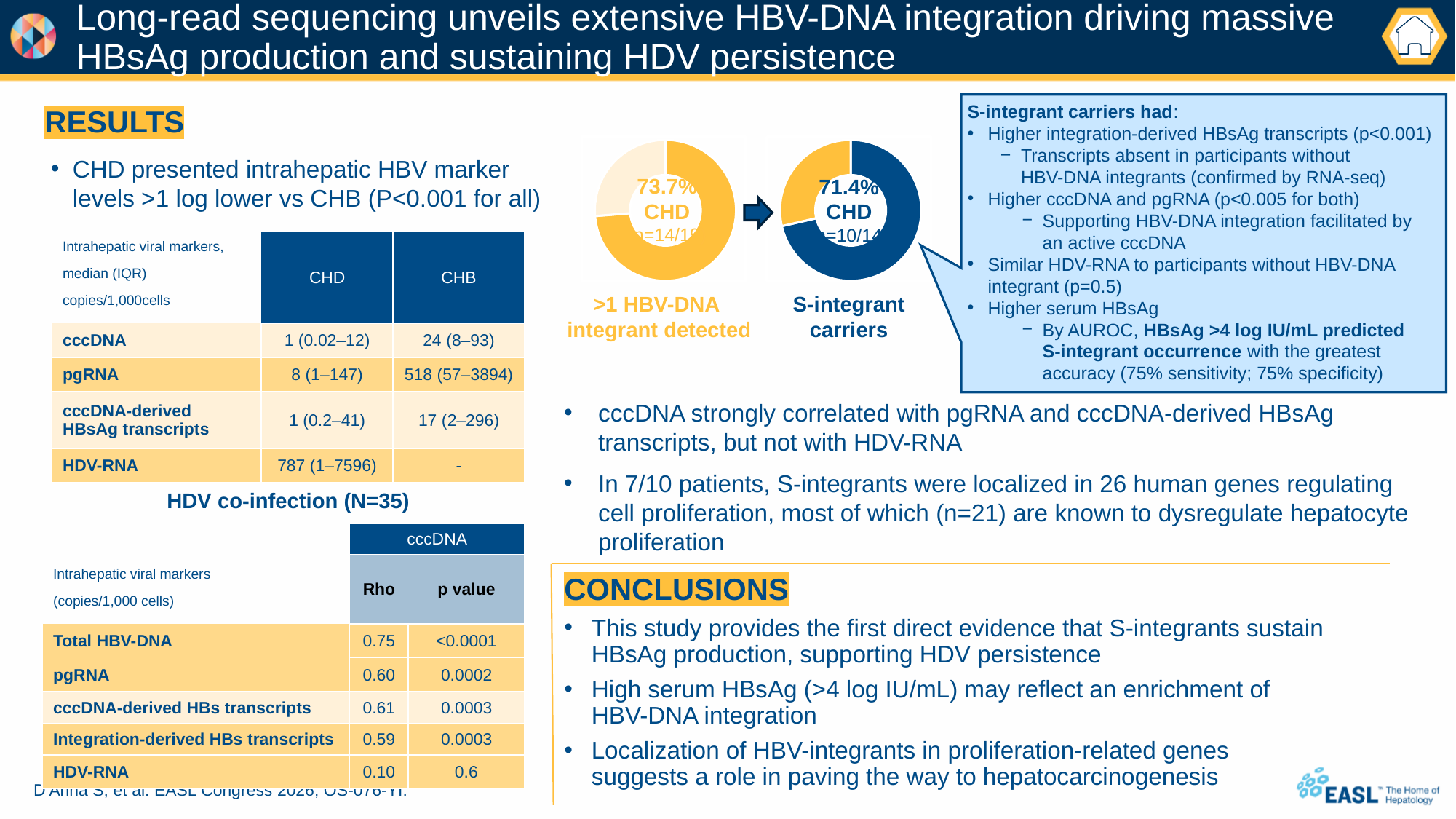
How many pie charts are shown on the slide? 2 In the '>1 HBV-DNA integrant detected' chart, what share of the pie is not covered by the 73.7% slice? 26.3% How many slices does the 'S-integrant carriers' pie chart have? 2 In the '>1 HBV-DNA integrant detected' chart, is the CHD value greater or less than 50%? greater What is the difference between the CHD percentage in the '>1 HBV-DNA integrant detected' chart (73.7%) and in the 'S-integrant carriers' chart (71.4%)? 2.3% What is the label under the left pie chart? >1 HBV-DNA integrant detected In the 'S-integrant carriers' chart, what share of the pie is not covered by the 71.4% slice? 28.6% What colour is the large 71.4% slice in the 'S-integrant carriers' chart? dark blue Which is larger: the CHD percentage in the '>1 HBV-DNA integrant detected' chart or in the 'S-integrant carriers' chart? >1 HBV-DNA integrant detected In the '>1 HBV-DNA integrant detected' chart, what percentage of CHD participants is shown? 73.7% In the 'S-integrant carriers' chart, what percentage of CHD participants is shown? 71.4% What kind of chart is used to show the proportion of CHD participants with >1 HBV-DNA integrant detected? doughnut chart